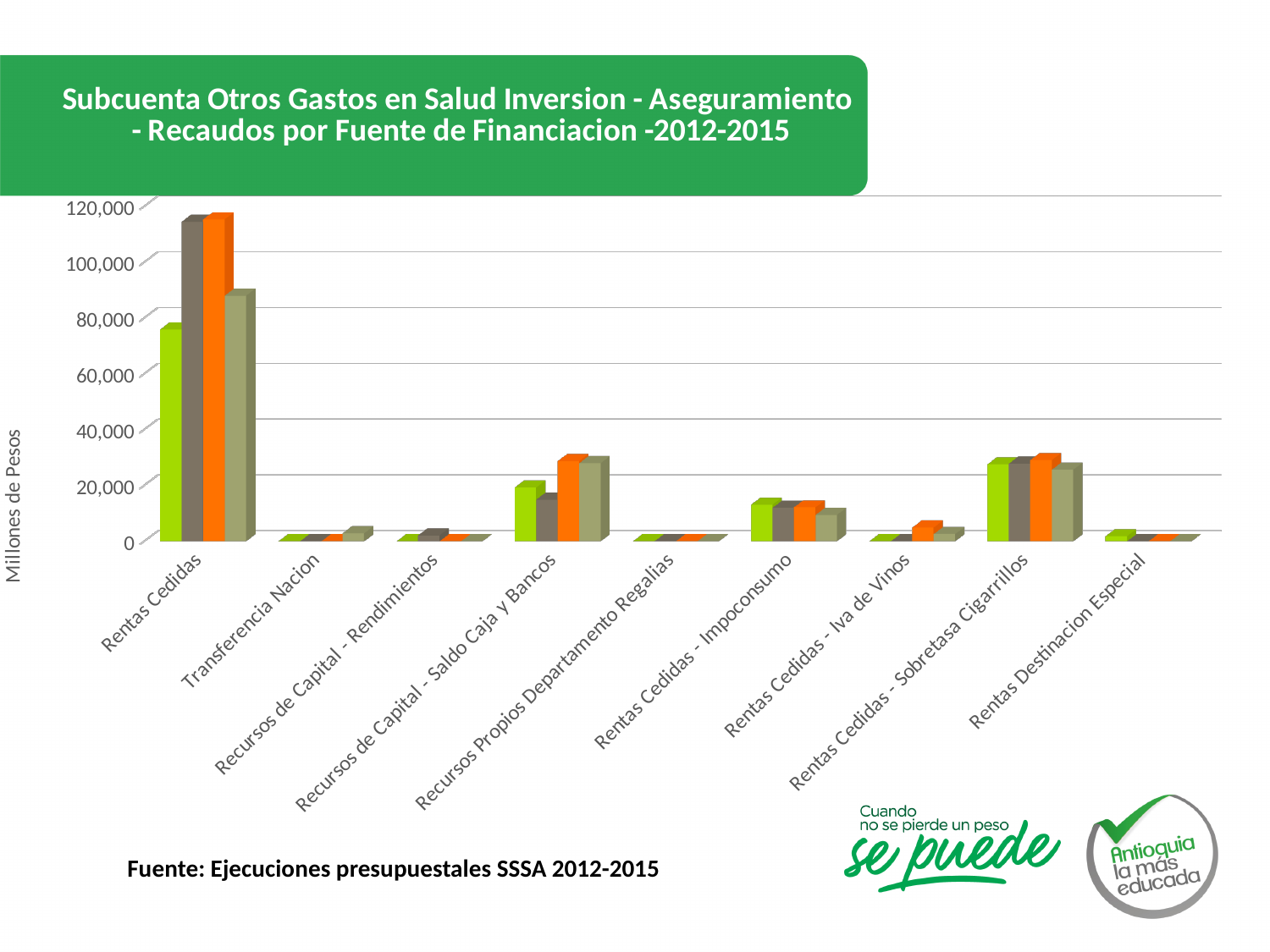
How many funding-source categories are shown on the x axis? 9 Is the value of the tallest bar for Rentas Cedidas greater or less than 100,000? greater Which category has the taller bars: Recursos de Capital - Saldo Caja y Bancos or Rentas Cedidas - Impoconsumo? Recursos de Capital - Saldo Caja y Bancos What kind of chart is shown on the slide? Bar chart Which category has larger values: Rentas Cedidas or Rentas Cedidas - Sobretasa Cigarrillos? Rentas Cedidas What is the label on the vertical axis of the chart? Millones de Pesos What is the highest value shown on the vertical axis? 120,000 Is the value of the tallest bar for Rentas Cedidas - Impoconsumo greater or less than 20,000? less Is the value of the tallest bar for Recursos de Capital - Saldo Caja y Bancos greater or less than 20,000? greater Which category has the highest bars in the chart? Rentas Cedidas